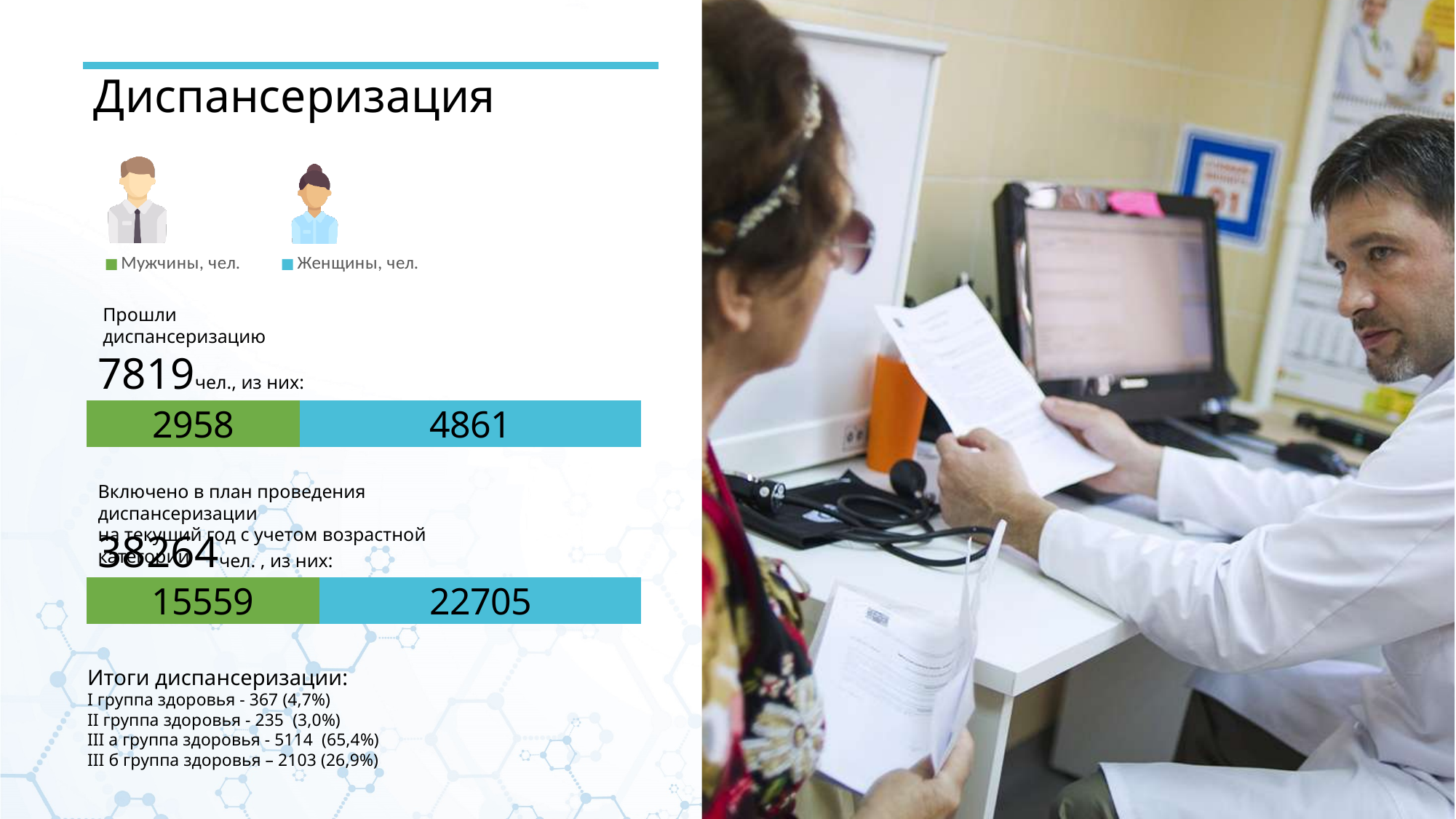
In the lower bar chart (Включено в план проведения диспансеризации), what is the value for Женщины, чел.? 22705 In the lower bar chart (Включено в план проведения диспансеризации), what is the difference between the values for Женщины and Мужчины? 7146 In the upper bar chart (Прошли диспансеризацию), what is the value for Мужчины, чел.? 2958 In the upper bar chart (Прошли диспансеризацию), what is the difference between the values for Женщины and Мужчины? 1903 In the upper bar chart (Прошли диспансеризацию), what is the value for Женщины, чел.? 4861 What is the total of the upper stacked bar (Прошли диспансеризацию)? 7819 What is the total of the lower stacked bar (Включено в план проведения диспансеризации)? 38264 In the lower bar chart (Включено в план проведения диспансеризации), which series has the smaller value? Мужчины, чел. In the lower bar chart (Включено в план проведения диспансеризации), what is the value for Мужчины, чел.? 15559 What colour represents Мужчины, чел. in the bar charts? Green In the upper bar chart (Прошли диспансеризацию), which series has the larger value, Мужчины or Женщины? Женщины How many series does the legend list for the bar charts? 2